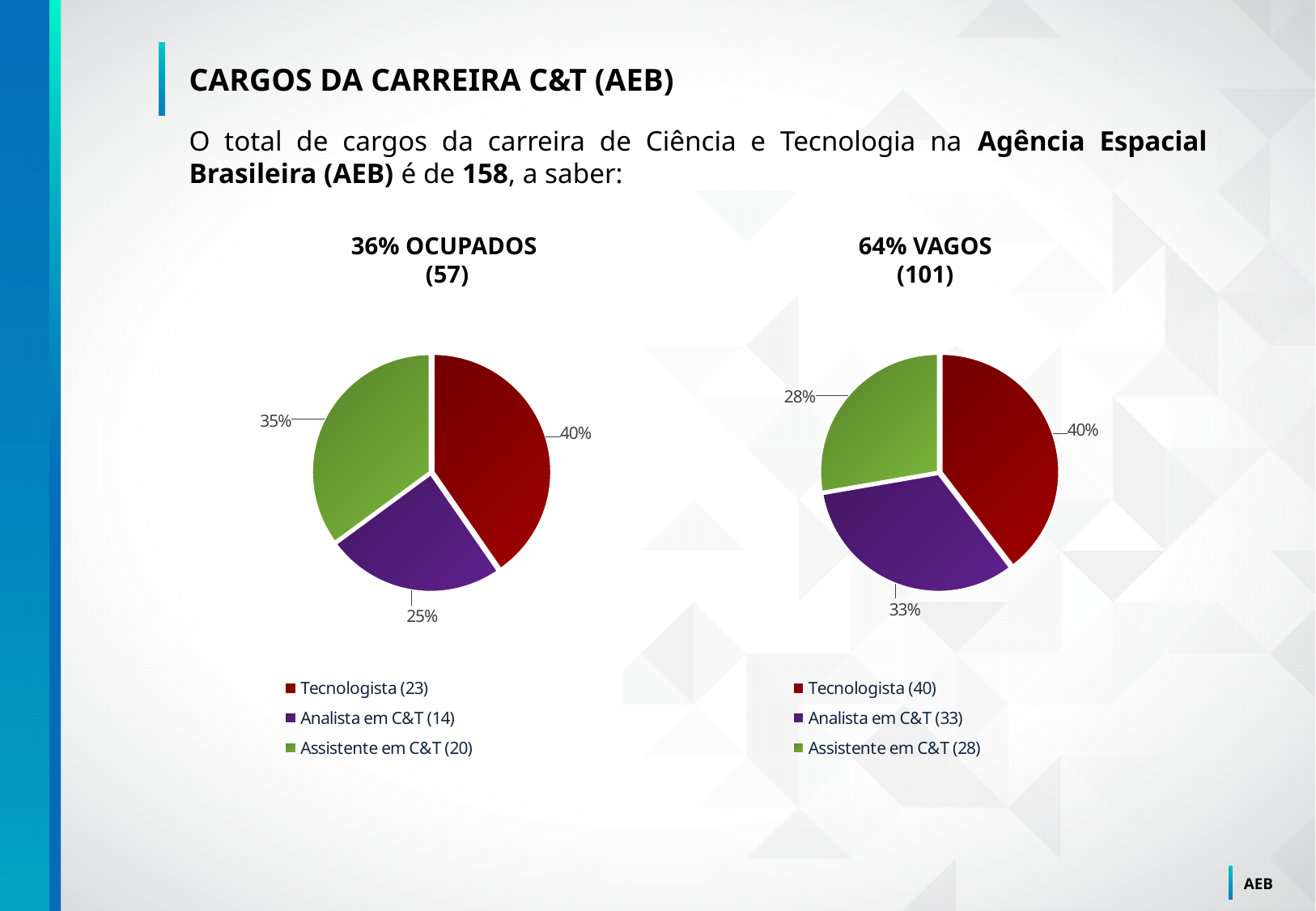
In the "64% VAGOS (101)" chart, which slice is larger: Analista em C&T or Assistente em C&T? Analista em C&T In the "36% OCUPADOS (57)" chart, what share of the pie is Tecnologista? 40% In the "36% OCUPADOS (57)" chart, which category has the smallest slice? Analista em C&T What kind of chart is the "36% OCUPADOS (57)" chart? pie chart In the "64% VAGOS (101)" chart, what share of the pie is Analista em C&T? 33% How many categories does the legend of the "64% VAGOS (101)" chart list? 3 In the "36% OCUPADOS (57)" chart, what share of the pie is Analista em C&T? 25% In the "36% OCUPADOS (57)" chart, what count is shown in the legend for Assistente em C&T? 20 In the "36% OCUPADOS (57)" chart, what is the difference in percentage points between the Tecnologista and Analista em C&T slices? 15 In the "64% VAGOS (101)" chart, which category has the largest slice? Tecnologista